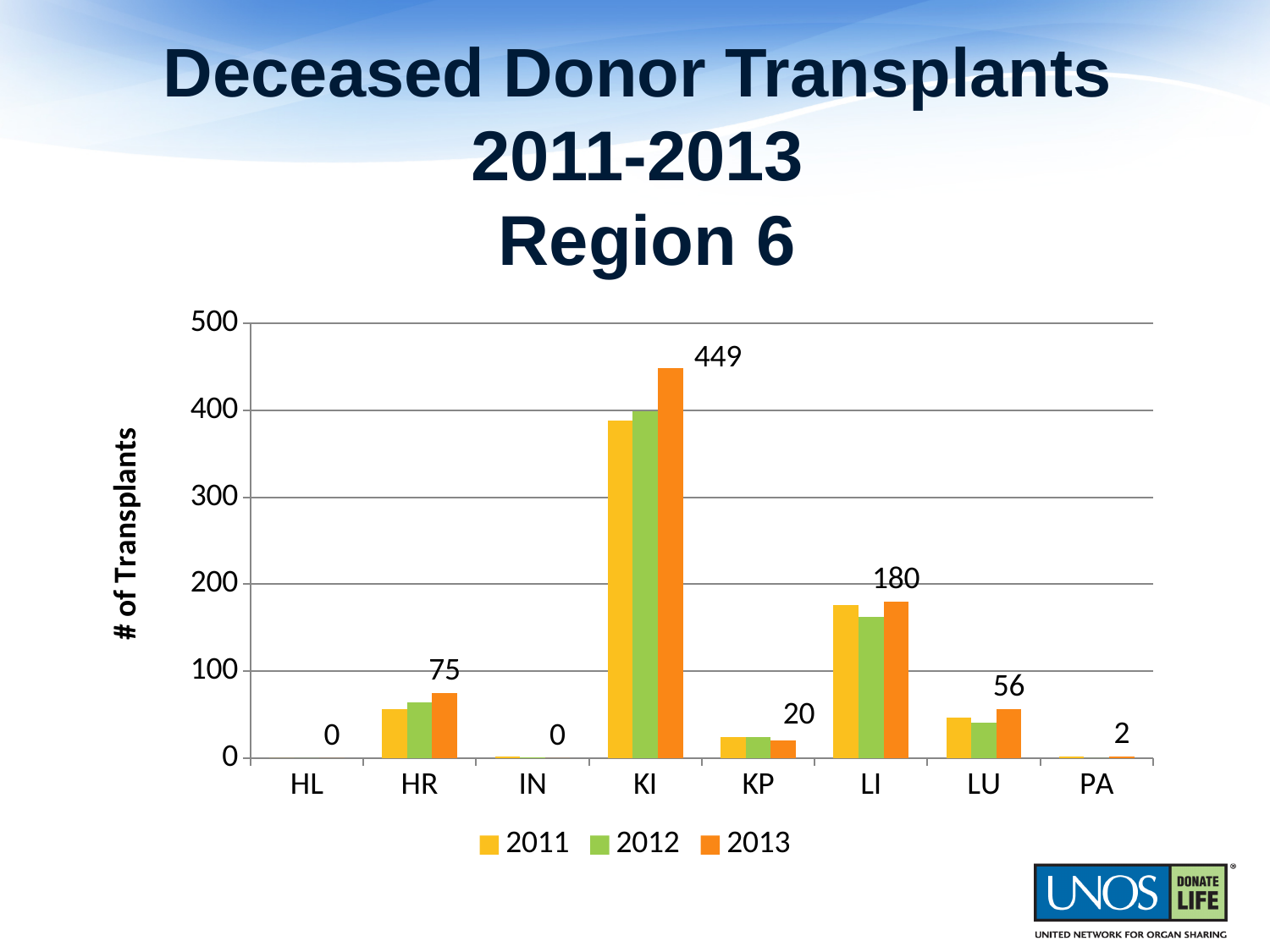
What is the 2013 value for HR? 75 Which category has the highest 2013 value? KI Which is larger, the 2013 value for HR or the 2013 value for LU? HR Is the 2011 value for KI greater or less than 300? greater What is the 2013 value for LU? 56 How many organ categories are shown on the x axis? 8 What is the difference between the 2013 values for KI and LI? 269 What is the 2013 value for LI? 180 What kind of chart is shown on the slide? bar chart What is the 2013 value for KI? 449 What is the 2013 value for PA? 2 How many series does the legend list? 3